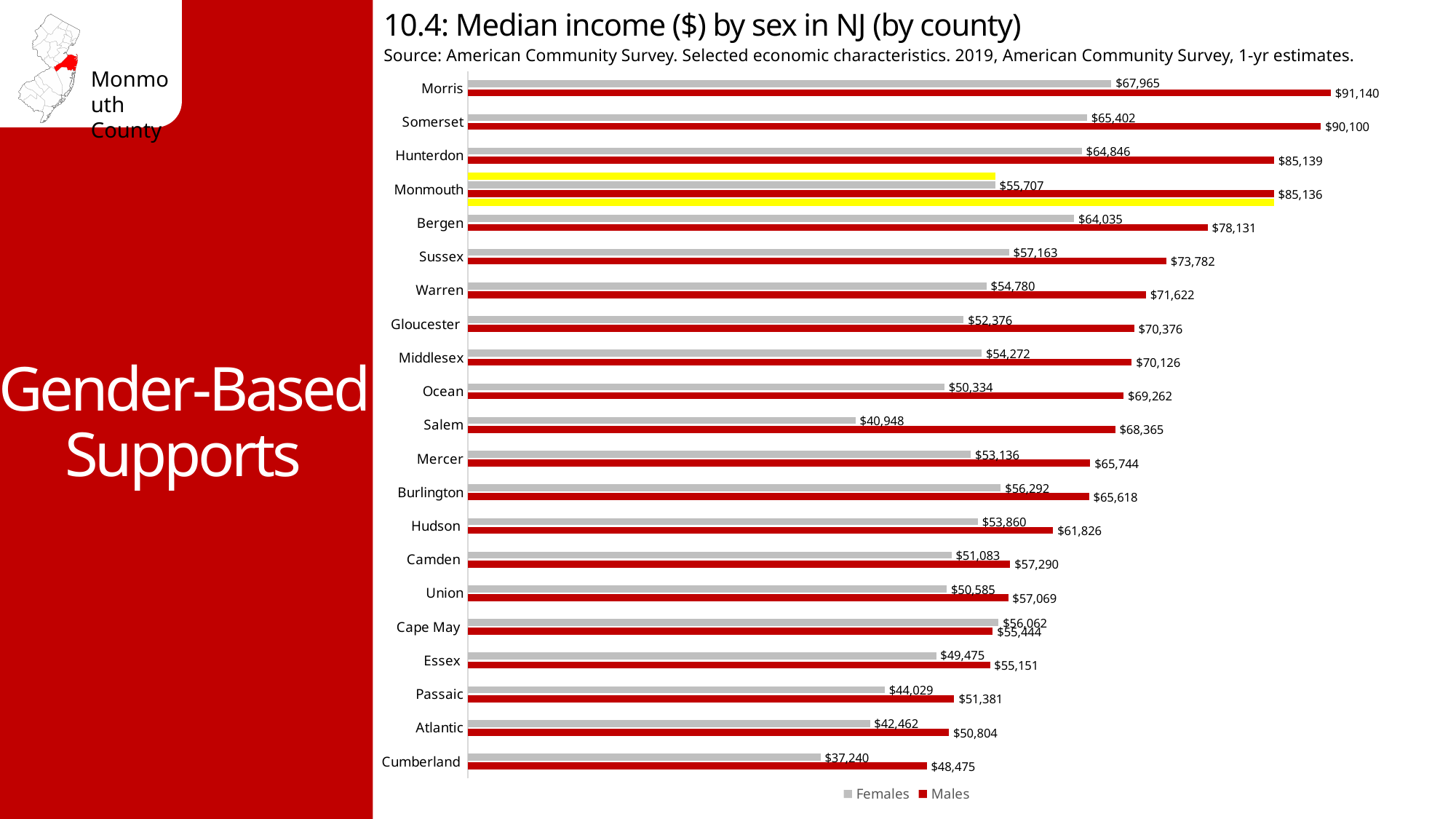
What is the median income for females in Monmouth County? $55,707 What is the difference between the male and female median incomes in Morris County? $23,175 What kind of chart is shown on the slide? Bar chart In Cape May County, which is larger: the female median income or the male median income? Females Which county has the highest median income for males? Morris What is the median income for females in Salem County? $40,948 Which county's bars are highlighted in yellow? Monmouth What is the difference between the male and female median incomes in Monmouth County? $29,429 What is the median income for males in Monmouth County? $85,136 How many series does the legend list? 2 How many counties are shown in the chart? 21 Which county has the lowest median income for females? Cumberland